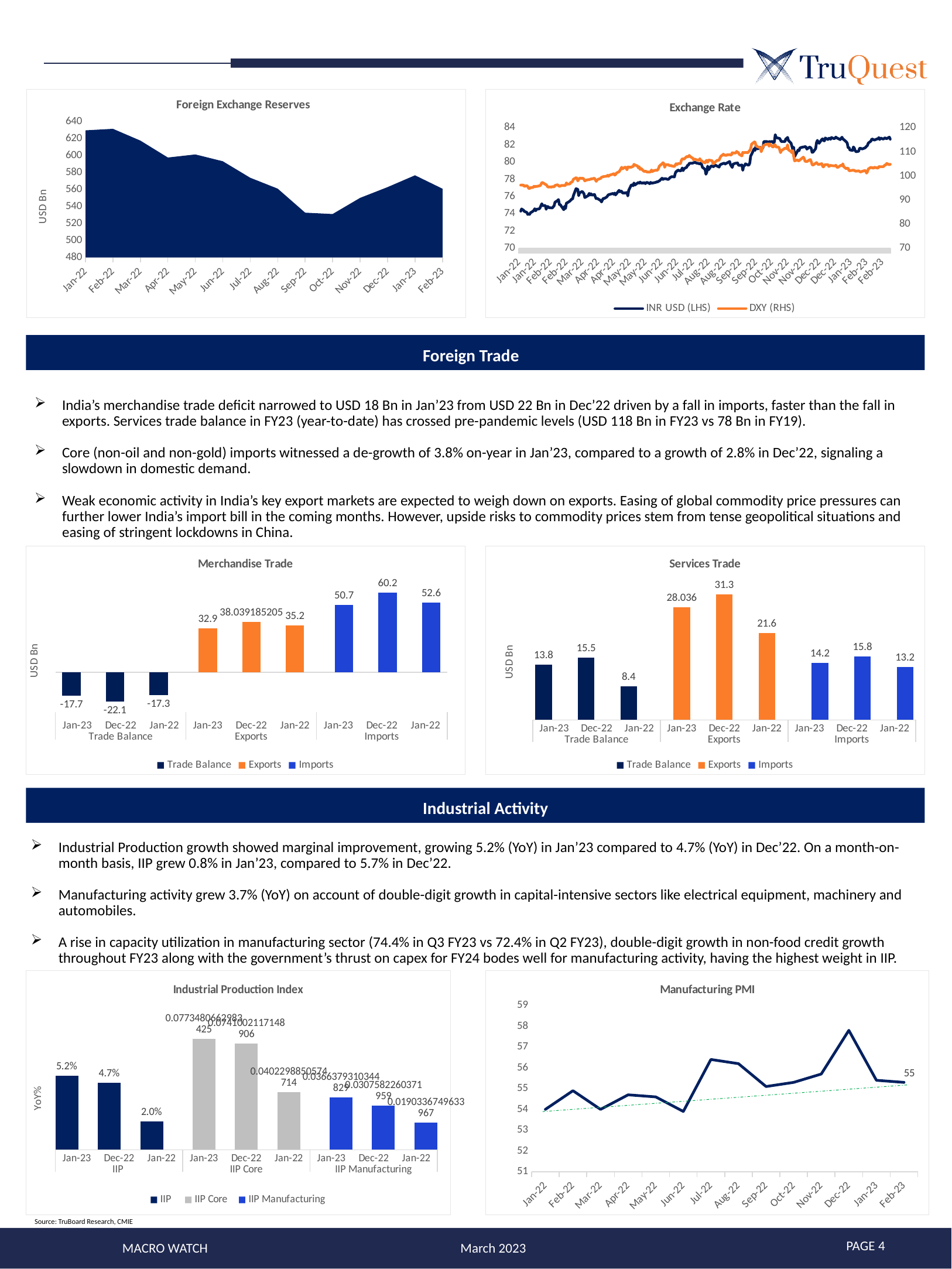
In the Foreign Exchange Reserves chart, is the value for Oct-22 greater or less than 540? less In the Exchange Rate chart, which series is plotted on the right-hand axis according to the legend? DXY (RHS) In the Services Trade chart, is the Imports value for Dec-22 larger than the Imports value for Jan-22? Yes In the Merchandise Trade chart, what is the Trade Balance for Dec-22? -22.1 In the Industrial Production Index chart, what is the IIP growth for Jan-23? 5.2% In the Services Trade chart, which month has the lowest Trade Balance? Jan-22 In the Manufacturing PMI chart, what is the value for Feb-23? 55 In the Manufacturing PMI chart, is the value for Dec-22 greater or less than 57? greater In the Industrial Production Index chart, how many series does the legend list? 3 In the Merchandise Trade chart, what is the value of Imports for Dec-22? 60.2 In the Services Trade chart, what is the value of Exports for Dec-22? 31.3 In the Merchandise Trade chart, what is the difference between Imports and Exports for Jan-23? 17.8